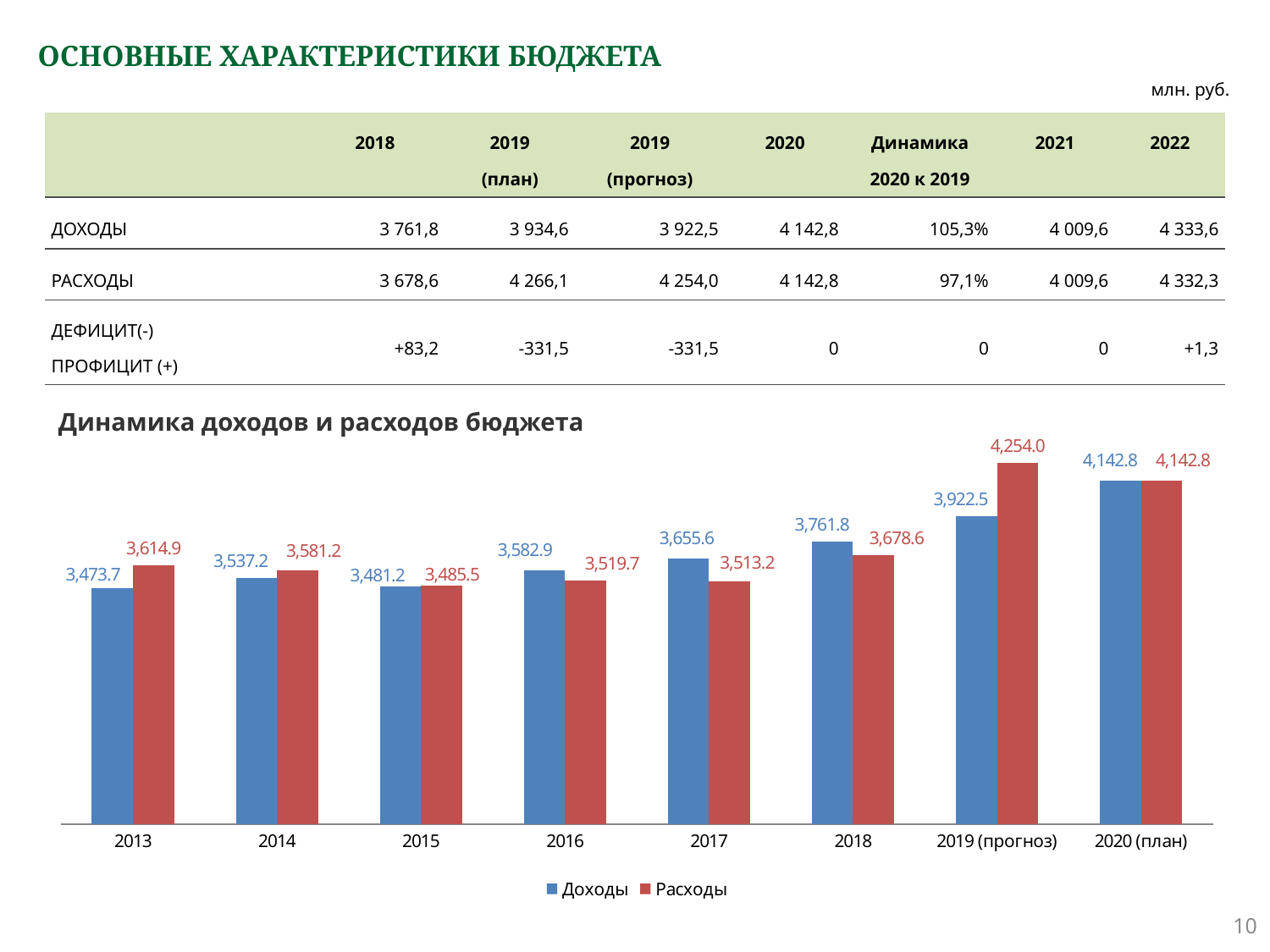
What is the value of Доходы for 2016 in the chart? 3,582.9 Which colour represents Расходы in the chart? red What is the value of Доходы for 2020 (план) in the chart? 4,142.8 What is the difference between Доходы and Расходы for 2018 in the chart? 83.2 What type of chart is shown under the title "Динамика доходов и расходов бюджета"? bar chart How many series does the legend of the chart list? 2 What is the difference between Расходы and Доходы for 2019 (прогноз) in the chart? 331.5 How many year categories are shown on the x axis of the chart? 8 What is the value of Расходы for 2019 (прогноз) in the chart? 4,254.0 In which year is Расходы highest in the chart? 2019 (прогноз) In which year is Доходы lowest in the chart? 2013 For 2017, which is larger in the chart: Доходы or Расходы? Доходы